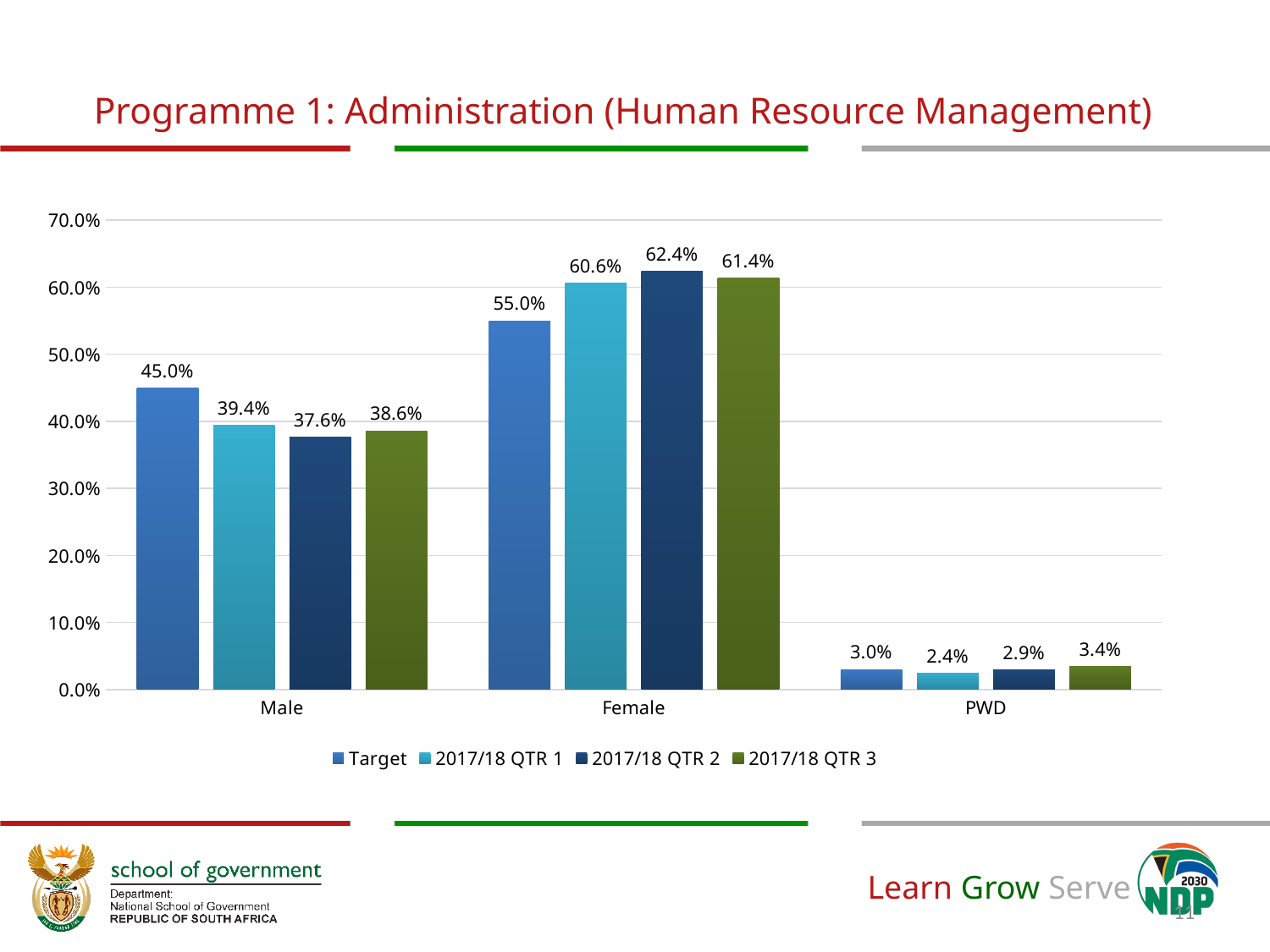
Is the 2017/18 QTR 3 value for Female greater or less than 60.0%? greater What is the Target value for Female? 55.0% How many categories are shown on the x axis? 3 Which is larger for Male: the Target value or the 2017/18 QTR 1 value? Target Which category has the lowest Target value? PWD What is the 2017/18 QTR 3 value for PWD? 3.4% How many series does the legend list? 4 What is the title of the slide? Programme 1: Administration (Human Resource Management) What is the difference between the 2017/18 QTR 2 and Target values for Female? 7.4% What kind of chart is shown on the slide? bar chart Which category has the highest 2017/18 QTR 1 value? Female What is the 2017/18 QTR 2 value for Male? 37.6%